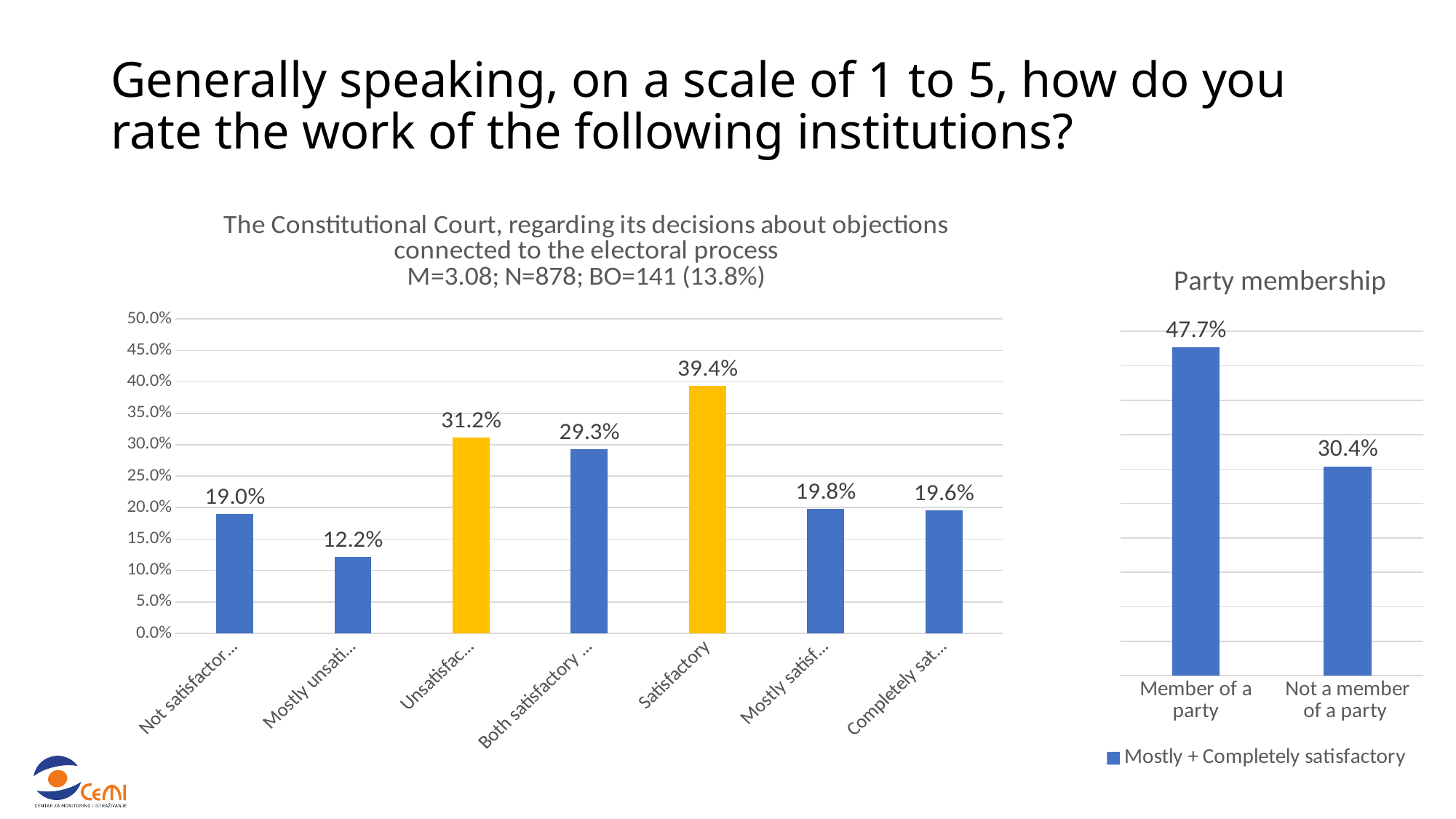
In the Constitutional Court chart, how many bars are coloured yellow rather than blue? 2 What kind of chart is the Constitutional Court chart? Bar chart In the Constitutional Court chart, what is the lowest value shown on any bar? 12.2% In the Constitutional Court chart, what is the value for Satisfactory? 39.4% In the Party membership chart, which category has the higher value, Member of a party or Not a member of a party? Member of a party How many bars are plotted in the Constitutional Court chart? 7 In the Party membership chart, what is the difference between the values for Member of a party and Not a member of a party? 17.3% In the Constitutional Court chart, what is the value of the first bar from the left? 19.0% In the Party membership chart, what is the value for Not a member of a party? 30.4% In the Party membership chart, what series does the legend list? Mostly + Completely satisfactory In the Party membership chart, what is the value for Member of a party? 47.7% In the Constitutional Court chart, which category has the highest value? Satisfactory